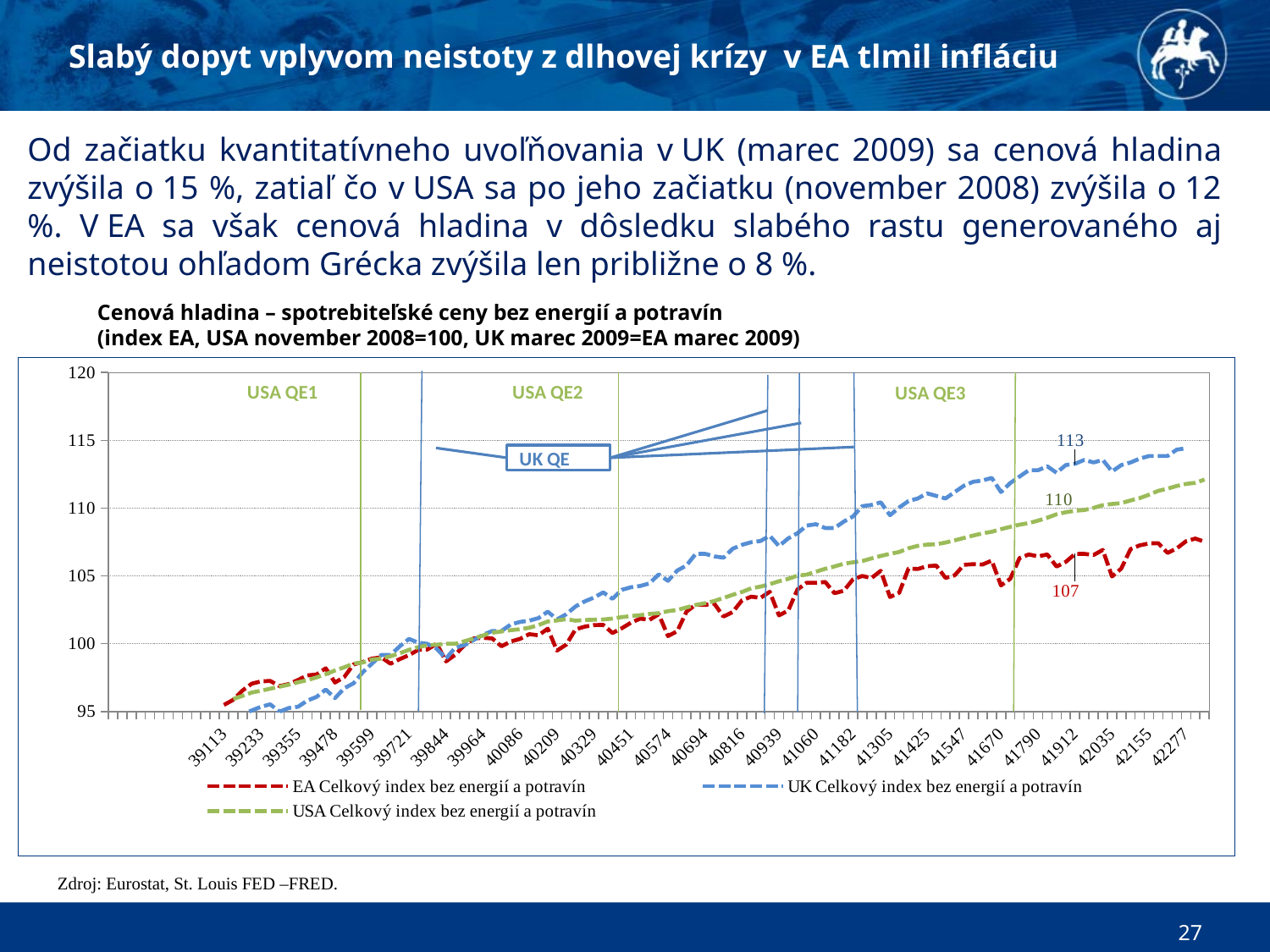
What value is printed as the data label on the USA series (USA Celkový index bez energií a potravín)? 110 Is the value of the EA series at the right end of the chart greater or less than 105? greater What is the title of the chart? Cenová hladina – spotrebiteľské ceny bez energií a potravín (index EA, USA november 2008=100, UK marec 2009=EA marec 2009) What is the difference between the data label on the UK series (113) and the data label on the EA series (107)? 6 Do the values of the three series generally rise or fall along the x axis? rise What value is printed as the data label on the UK series (UK Celkový index bez energií a potravín)? 113 Which is larger, the labelled value on the UK series or the labelled value on the USA series? UK series (113) How many series does the chart legend list? 3 What kind of chart is shown on the slide? line chart What value is printed as the data label on the EA series (EA Celkový index bez energií a potravín)? 107 Which series has the lowest value at the right end of the chart? EA Celkový index bez energií a potravín Which series has the highest value at the right end of the chart? UK Celkový index bez energií a potravín